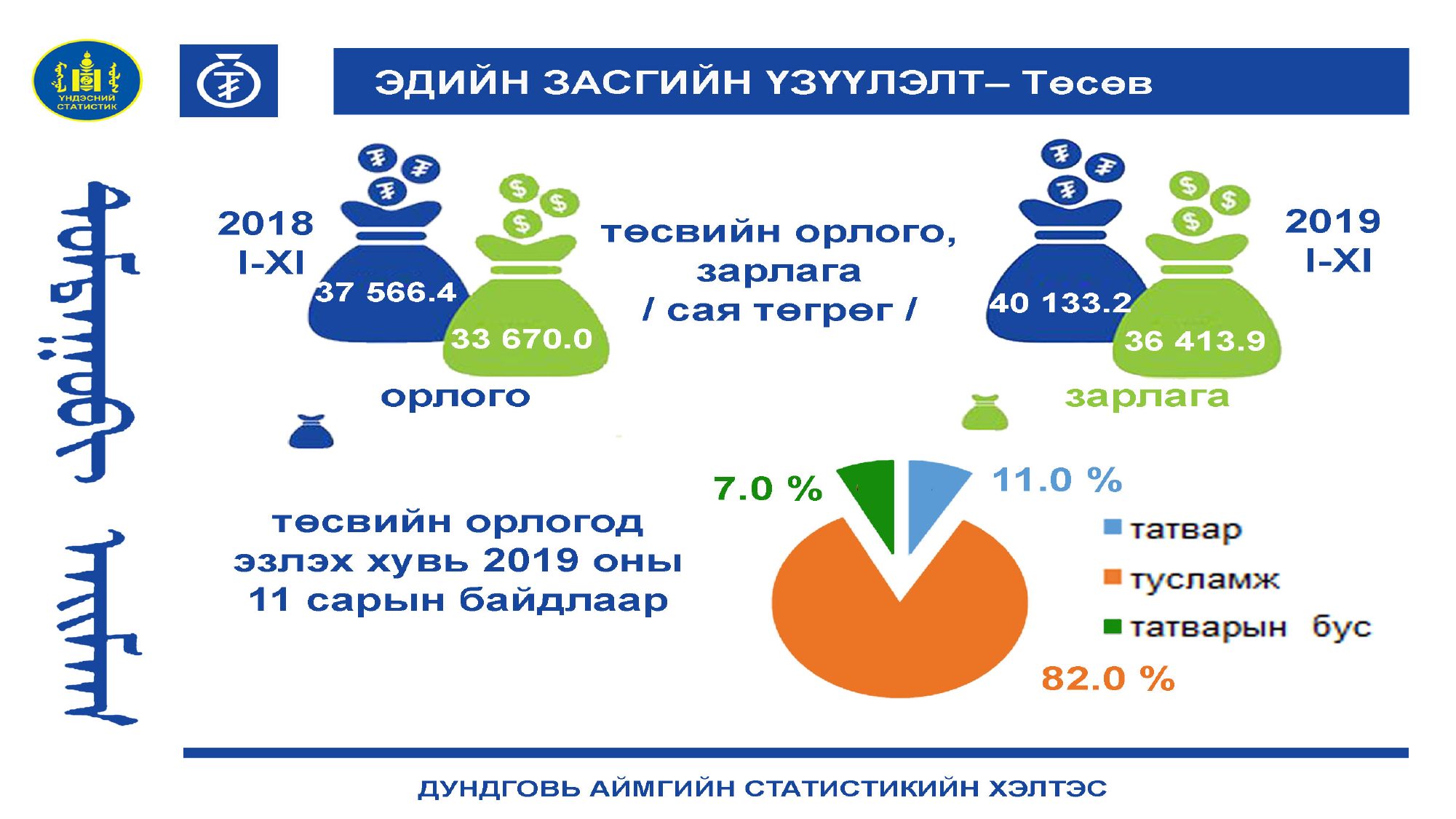
What is the difference between the татвар slice and the татварын бус slice? 4.0 % Which slice is larger, татвар or татварын бус? татвар What share of the pie chart does тусламж account for? 82.0 % How many entries does the pie chart legend list? 3 Which category has the smallest slice in the pie chart? татварын бус By how many percentage points does the тусламж slice exceed the татвар slice? 71.0 % Which category has the largest slice in the pie chart? тусламж How many slices does the pie chart have? 3 What share of the pie chart does татварын бус account for? 7.0 % What colour is the тусламж slice in the pie chart? orange What share of the pie chart does татвар account for? 11.0 % What kind of chart is shown on the slide? pie chart